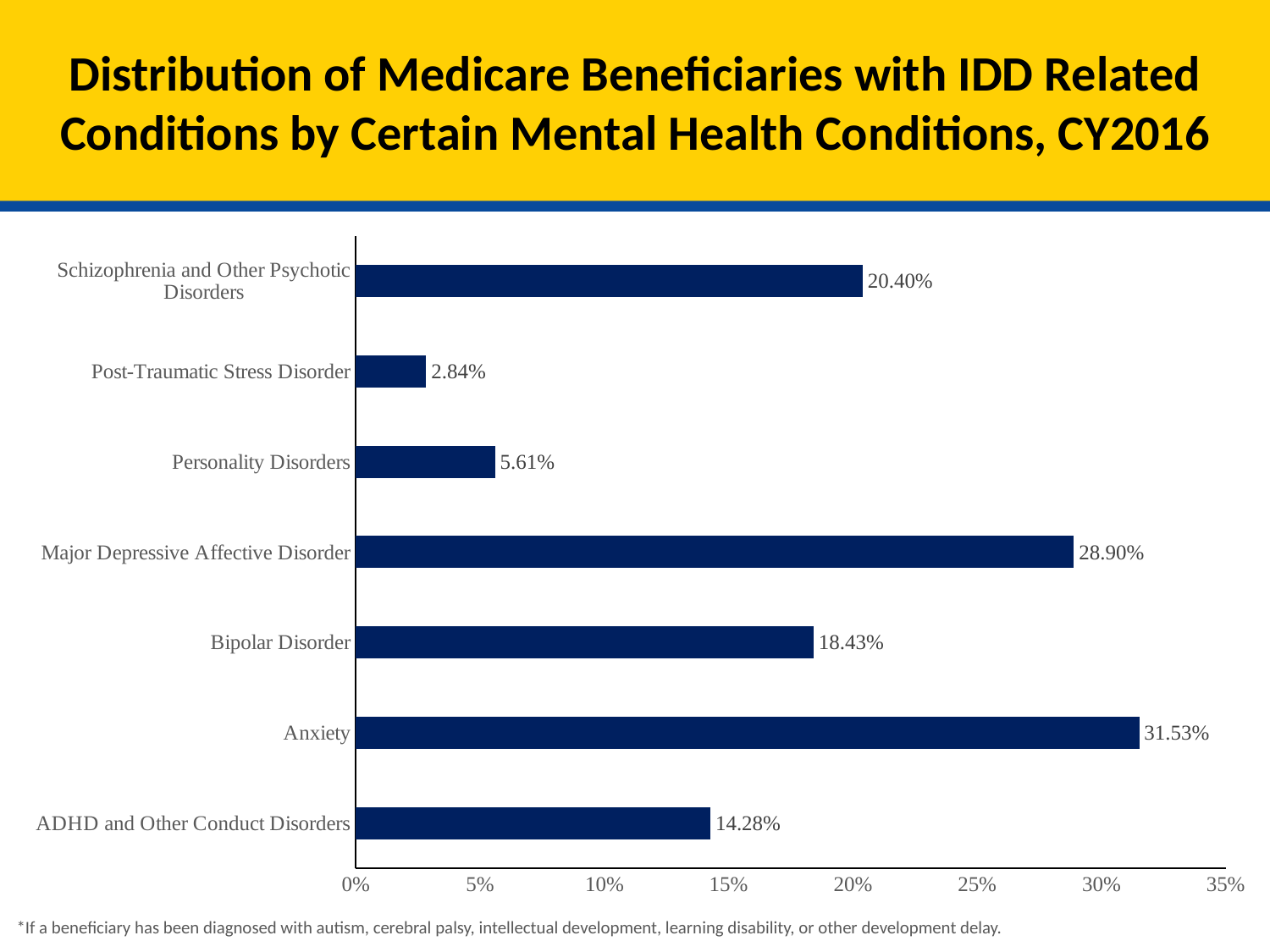
What is the maximum value shown on the x axis? 35% Which condition has the lowest value? Post-Traumatic Stress Disorder What kind of chart is shown on the slide? Bar chart What is the value for Post-Traumatic Stress Disorder? 2.84% What is the value for Anxiety? 31.53% What is the value for Bipolar Disorder? 18.43% What is the difference between the values for Schizophrenia and Other Psychotic Disorders and Bipolar Disorder? 1.97% How many conditions are shown in the chart? 7 What is the difference between the values for Anxiety and Major Depressive Affective Disorder? 2.63% Which condition has the highest value? Anxiety Which is larger, the value for Personality Disorders or the value for Post-Traumatic Stress Disorder? Personality Disorders What is the value for ADHD and Other Conduct Disorders? 14.28%